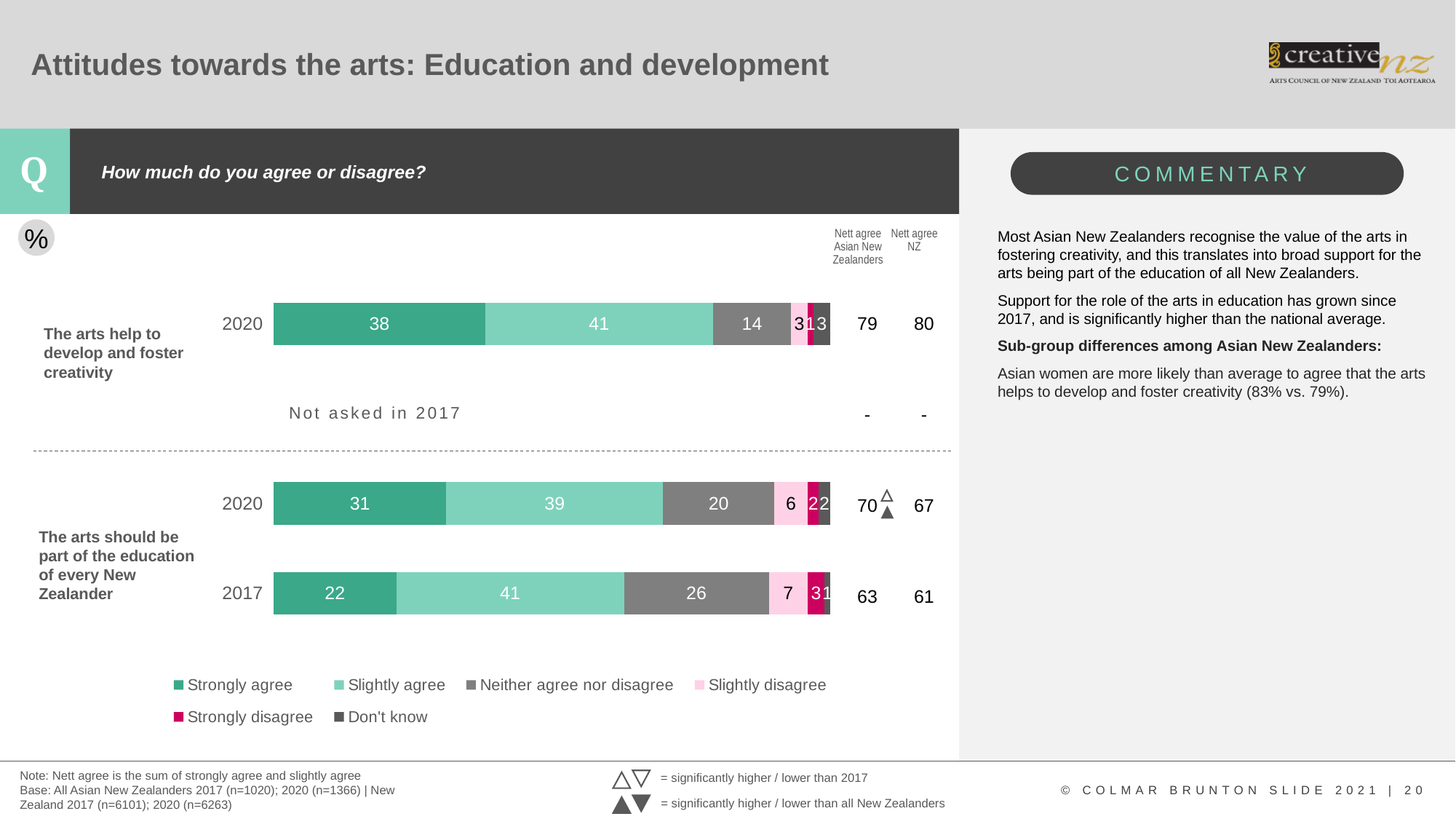
Which year has the larger 'Neither agree nor disagree' value for 'The arts should be part of the education of every New Zealander', 2017 or 2020? 2017 What kind of chart is shown on the slide? Stacked bar chart Which statement was not asked in 2017? The arts help to develop and foster creativity What is the Nett agree NZ figure for 2017 for 'The arts should be part of the education of every New Zealander'? 61 What is the difference between the Nett agree for Asian New Zealanders and Nett agree NZ in 2020 for 'The arts should be part of the education of every New Zealander'? 3 What is the Nett agree figure for Asian New Zealanders in 2020 for 'The arts help to develop and foster creativity'? 79 What is the 'Slightly agree' value for the 2017 bar for 'The arts should be part of the education of every New Zealander'? 41 What is the 'Neither agree nor disagree' value for the 2020 bar for 'The arts should be part of the education of every New Zealander'? 20 How many series does the legend list? 6 What percentage of Asian New Zealanders strongly agree in 2020 that the arts help to develop and foster creativity? 38 Which segment is the largest in the 2020 bar for 'The arts help to develop and foster creativity'? Slightly agree By how much did the 'Strongly agree' value for 'The arts should be part of the education of every New Zealander' change from 2017 to 2020? 9